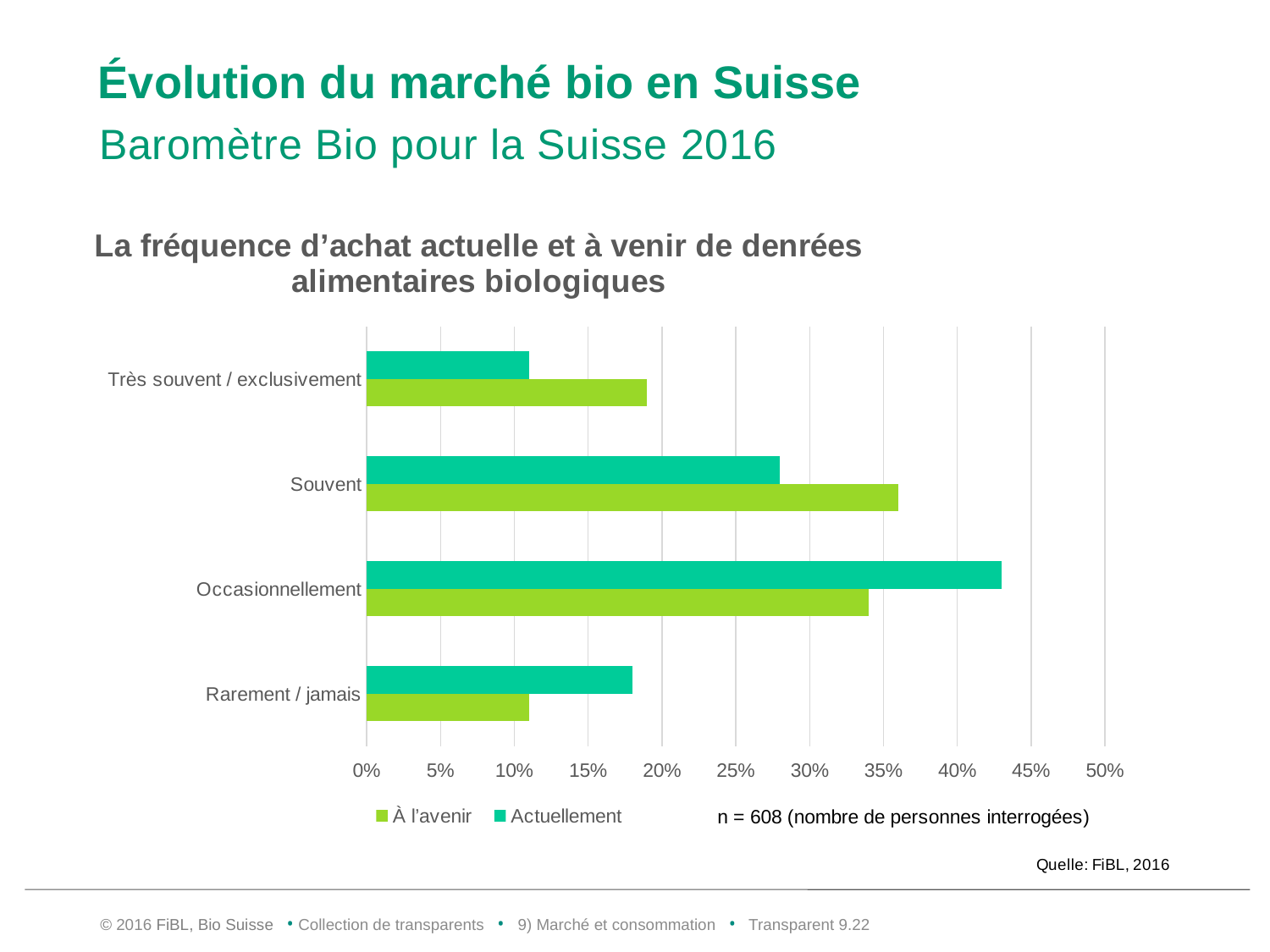
Is the 'Actuellement' value for 'Occasionnellement' greater or less than 40%? greater Is the 'Actuellement' value for 'Très souvent / exclusivement' greater or less than 15%? less For 'Rarement / jamais', which series has the larger value, 'À l'avenir' or 'Actuellement'? Actuellement Which category has the lowest value for the 'À l'avenir' series? Rarement / jamais How many series does the legend list? 2 For 'Très souvent / exclusivement', which series has the larger value, 'À l'avenir' or 'Actuellement'? À l'avenir What is the title of the chart? La fréquence d'achat actuelle et à venir de denrées alimentaires biologiques How many purchase-frequency categories are shown on the chart? 4 Which category has the highest value for the 'Actuellement' series? Occasionnellement Which category has the lowest value for the 'Actuellement' series? Très souvent / exclusivement What kind of chart is shown on the slide? bar chart Is the 'À l'avenir' value for 'Souvent' greater or less than 30%? greater